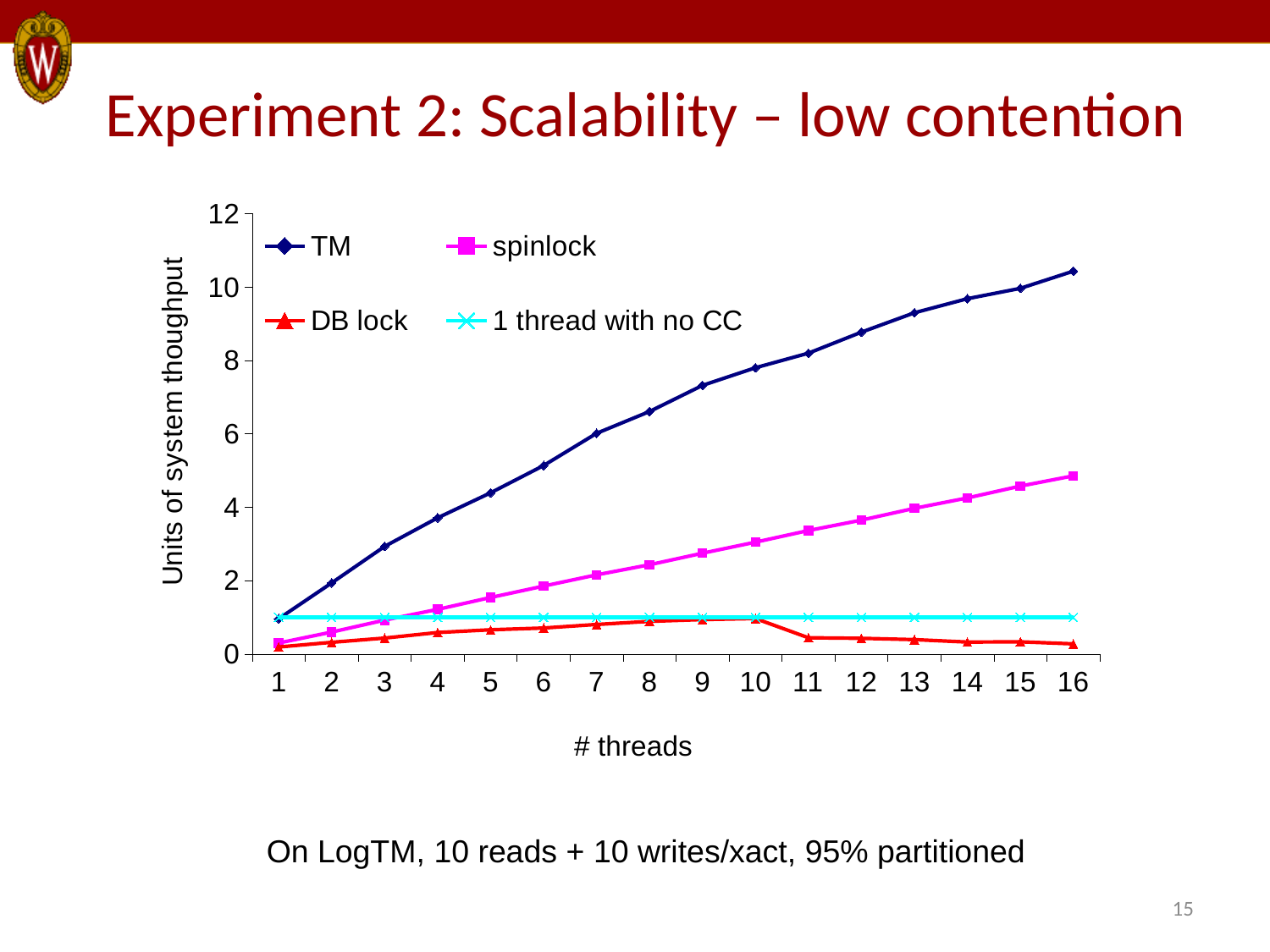
Is the value for spinlock at 16 threads greater or less than 6? less Which series has the lowest throughput at 16 threads? DB lock Is the value for TM at 16 threads greater or less than 10? greater Is the value for DB lock at 16 threads greater or less than 2? less At 16 threads, which is larger: spinlock or DB lock? spinlock How many thread counts are plotted along the x axis? 16 Does the TM series rise or fall as the number of threads increases? rise Which series has the highest throughput at 16 threads? TM What is the label of the y axis? Units of system thoughput What kind of chart is shown on the slide? line chart How many series does the legend list? 4